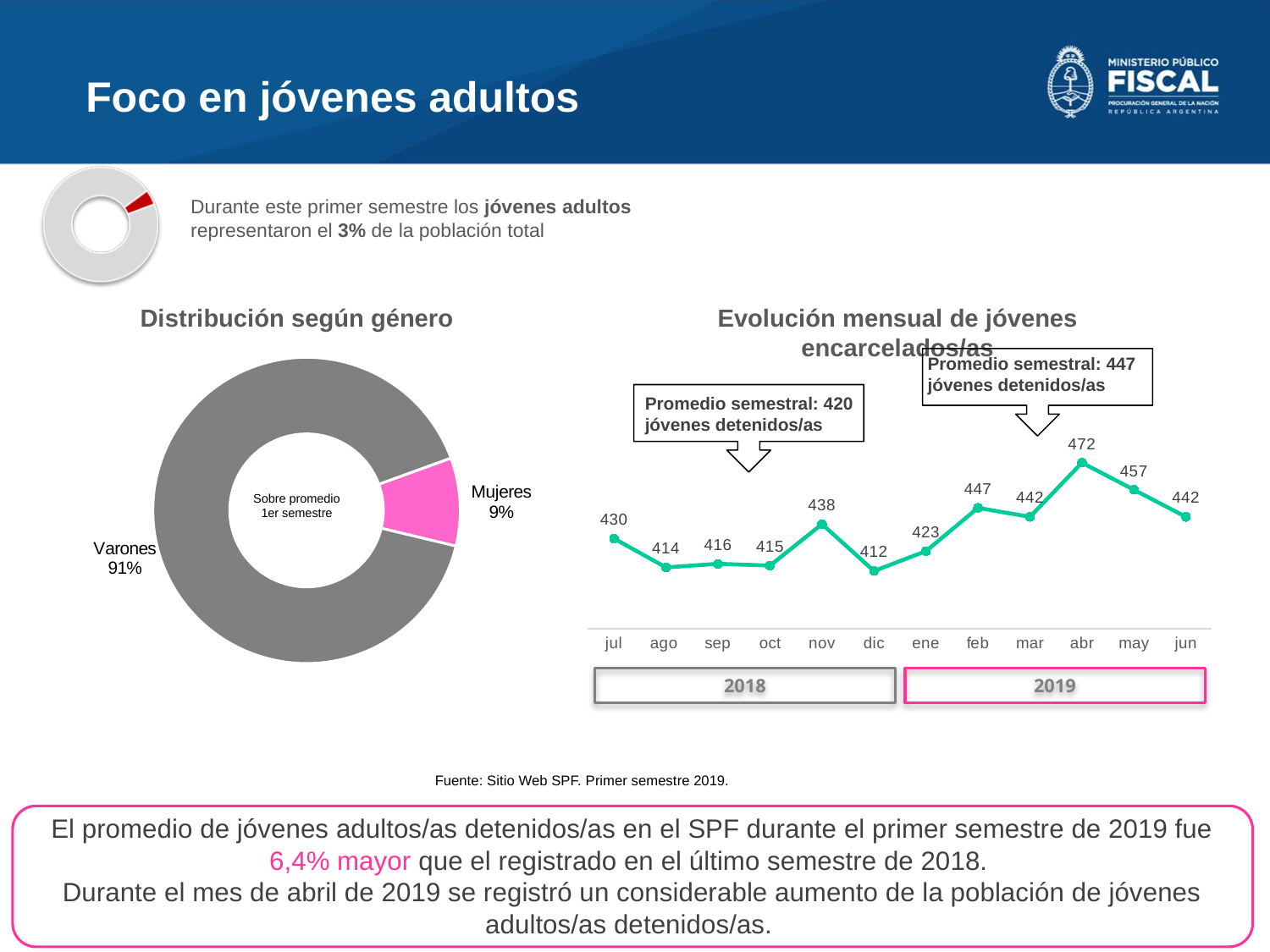
What kind of chart is 'Distribución según género'? Donut (pie) chart In the 'Distribución según género' chart, what share of the total is Mujeres? 9% According to the callout boxes on the 'Evolución mensual de jóvenes encarcelados/as' chart, what was the semester average for 2019? 447 jóvenes detenidos/as In the 'Evolución mensual de jóvenes encarcelados/as' chart, what is the value for dic? 412 In the 'Distribución según género' chart, what share of the total is Varones? 91% In the 'Evolución mensual de jóvenes encarcelados/as' chart, what is the value for abr? 472 How many months are plotted in the 'Evolución mensual de jóvenes encarcelados/as' chart? 12 What kind of chart is 'Evolución mensual de jóvenes encarcelados/as'? Line chart In the 'Evolución mensual de jóvenes encarcelados/as' chart, what is the difference between the values for abr and may? 15 In the 'Evolución mensual de jóvenes encarcelados/as' chart, which month has the lowest value? dic In the 'Evolución mensual de jóvenes encarcelados/as' chart, which month has the highest value? abr In the 'Evolución mensual de jóvenes encarcelados/as' chart, which is larger, the value for nov or the value for ene? nov